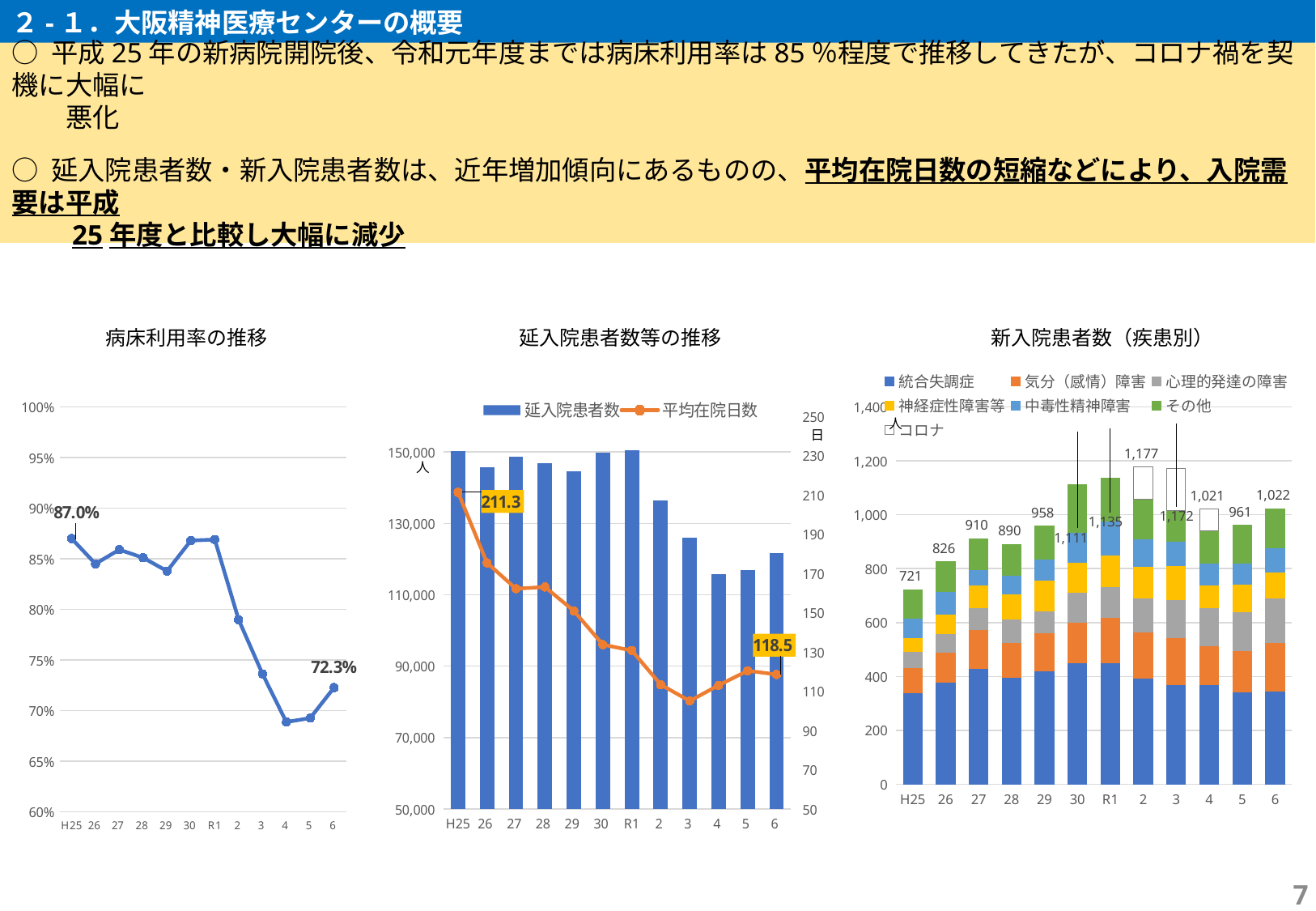
In the 延入院患者数等の推移 chart, what is the difference between the 平均在院日数 values for H25 and 6? 92.8 In the 病床利用率の推移 chart, what is the bed occupancy rate for H25? 87.0% In the 延入院患者数等の推移 chart, what is the 平均在院日数 value for 6? 118.5 What kind of chart is the 病床利用率の推移 chart? Line chart In the 延入院患者数等の推移 chart, what is the 平均在院日数 value for H25? 211.3 In the 新入院患者数（疾患別） chart, which year has the lowest total? H25 In the 新入院患者数（疾患別） chart, what is the total for H25? 721 How many series does the legend of the 新入院患者数（疾患別） chart list? 7 In the 延入院患者数等の推移 chart, is the 延入院患者数 bar for 4 greater or less than 130,000? less In the 病床利用率の推移 chart, is the value for 4 greater or less than 75%? less In the 病床利用率の推移 chart, what is the bed occupancy rate for 6? 72.3% In the 病床利用率の推移 chart, by how many percentage points did the rate fall from H25 to 6? 14.7 percentage points